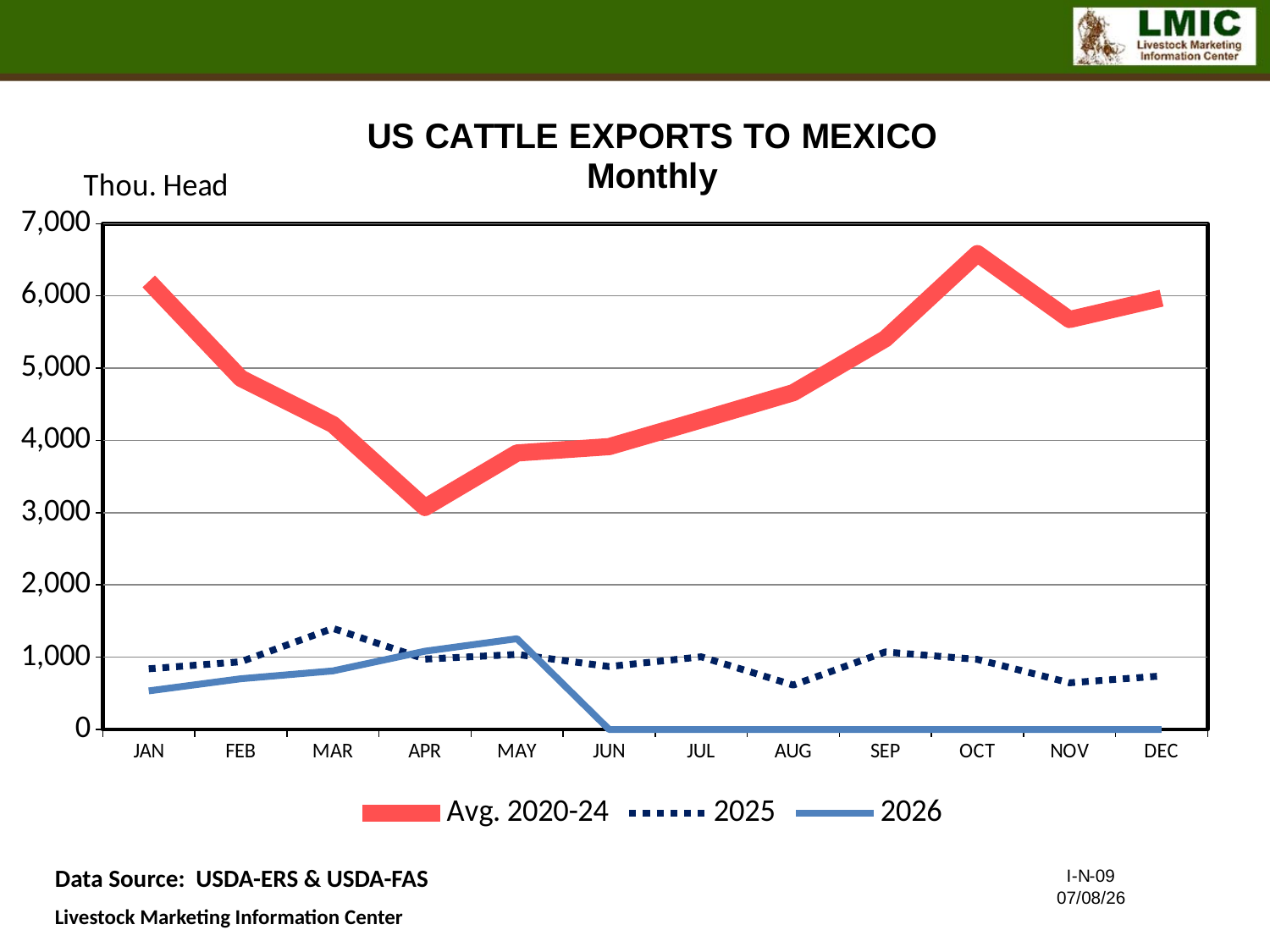
In which month is the Avg. 2020-24 series at its lowest? APR How many months are shown along the x axis? 12 Is the 2025 value for AUG greater or less than 1,000? less What kind of chart is shown on the slide? line chart Is the Avg. 2020-24 value for OCT greater or less than 6,000? greater Which series has the larger value in MAR, 2025 or 2026? 2025 In which month is the Avg. 2020-24 series at its highest? OCT In which month is the 2025 series at its highest? MAR Does the Avg. 2020-24 series rise or fall from JAN to APR? fall What unit is shown on the y axis label? Thou. Head How many series does the legend list? 3 Is the Avg. 2020-24 value for APR greater or less than 4,000? less